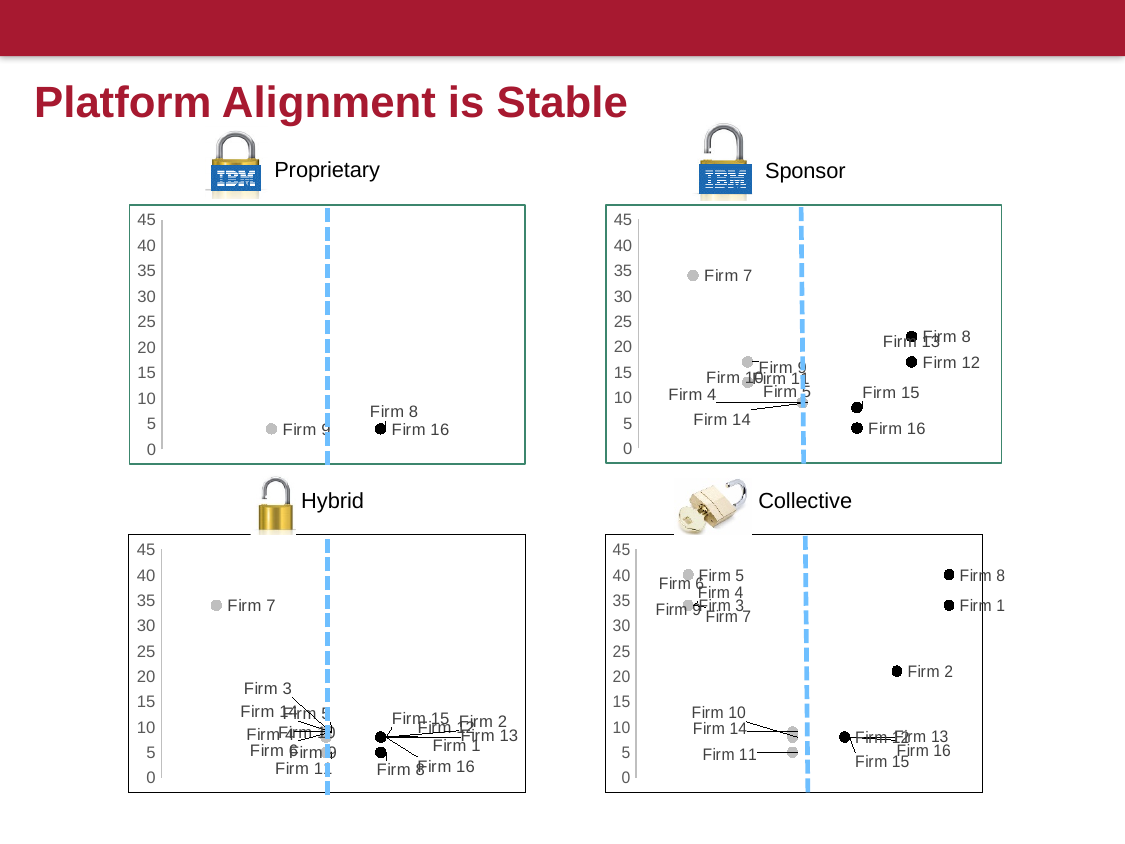
In the Sponsor chart, which firm has the highest value? Firm 7 In the Collective chart, which is larger, the value for Firm 1 or the value for Firm 2? Firm 1 In the Proprietary chart, is the value for Firm 9 greater or less than 10? less What kind of chart is the Sponsor chart? scatter chart In the Sponsor chart, is the value for Firm 16 greater or less than 10? less What is the highest value shown on the vertical axis of the Collective chart? 45 In the Hybrid chart, is the value for Firm 7 greater or less than 30? greater In the Sponsor chart, which is larger, the value for Firm 7 or the value for Firm 16? Firm 7 In the Hybrid chart, which firm has the highest value? Firm 7 In the Hybrid chart, which is larger, the value for Firm 7 or the value for Firm 3? Firm 7